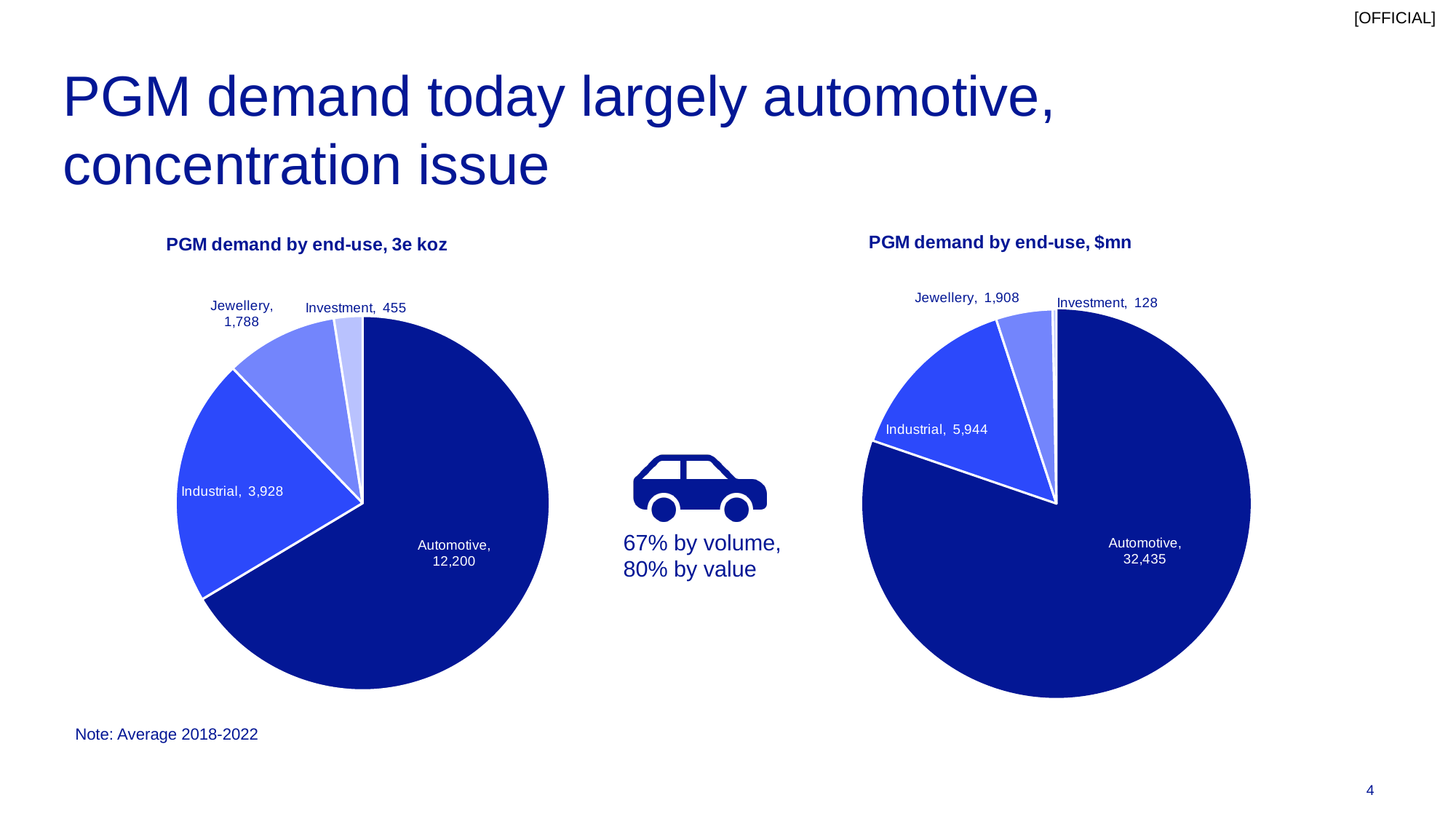
In the 'PGM demand by end-use, 3e koz' chart, what is the value for Investment? 455 In the 'PGM demand by end-use, $mn' chart, what is the value for Jewellery? 1,908 In the 'PGM demand by end-use, $mn' chart, what is the difference between Automotive and Industrial? 26,491 In the 'PGM demand by end-use, $mn' chart, what is the value for Industrial? 5,944 What type of chart is the 'PGM demand by end-use, 3e koz' chart? Pie chart In the 'PGM demand by end-use, 3e koz' chart, which end-use has the largest value? Automotive What is the title of the chart on the right side of the slide? PGM demand by end-use, $mn In the 'PGM demand by end-use, 3e koz' chart, what is the difference between Industrial and Jewellery? 2,140 In the 'PGM demand by end-use, 3e koz' chart, which is larger, Jewellery or Investment? Jewellery In the 'PGM demand by end-use, 3e koz' chart, what is the value for Automotive? 12,200 In the 'PGM demand by end-use, $mn' chart, which end-use has the smallest value? Investment How many slices does the 'PGM demand by end-use, $mn' chart have? 4